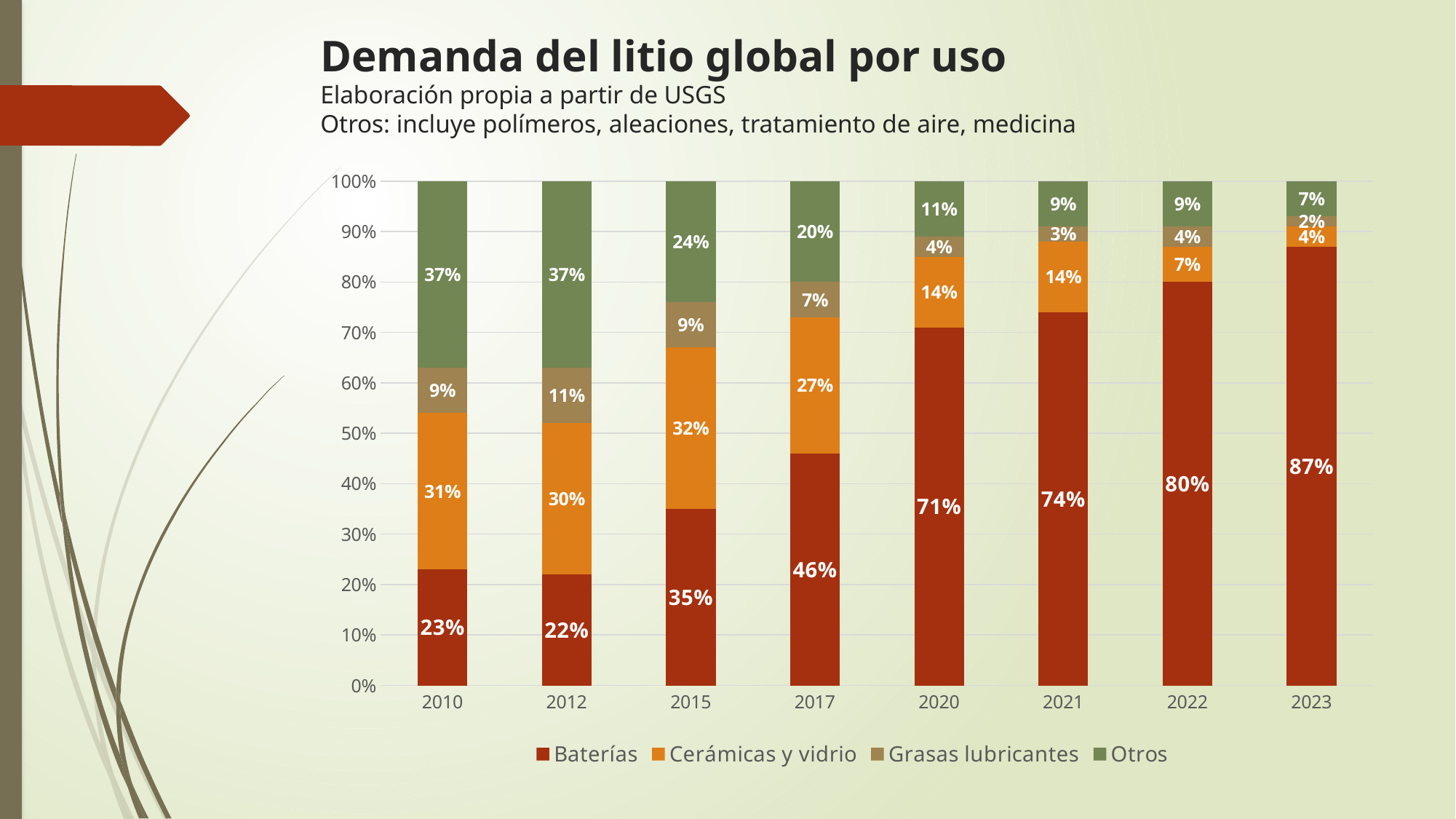
How many years are shown on the x axis? 8 In which year is the Baterías share highest? 2023 How many series does the legend list? 4 What is the value for Cerámicas y vidrio in 2015? 32% What is the value for Baterías in 2023? 87% In which year is the Baterías share lowest? 2012 What kind of chart is shown on the slide? Stacked bar chart Which is larger in 2020: the share for Cerámicas y vidrio or the share for Otros? Cerámicas y vidrio Does the Otros share rise or fall from 2010 to 2023? Fall What is the difference between the Baterías share in 2023 and in 2010? 64% What is the value for Otros in 2017? 20% What is the value for Grasas lubricantes in 2012? 11%